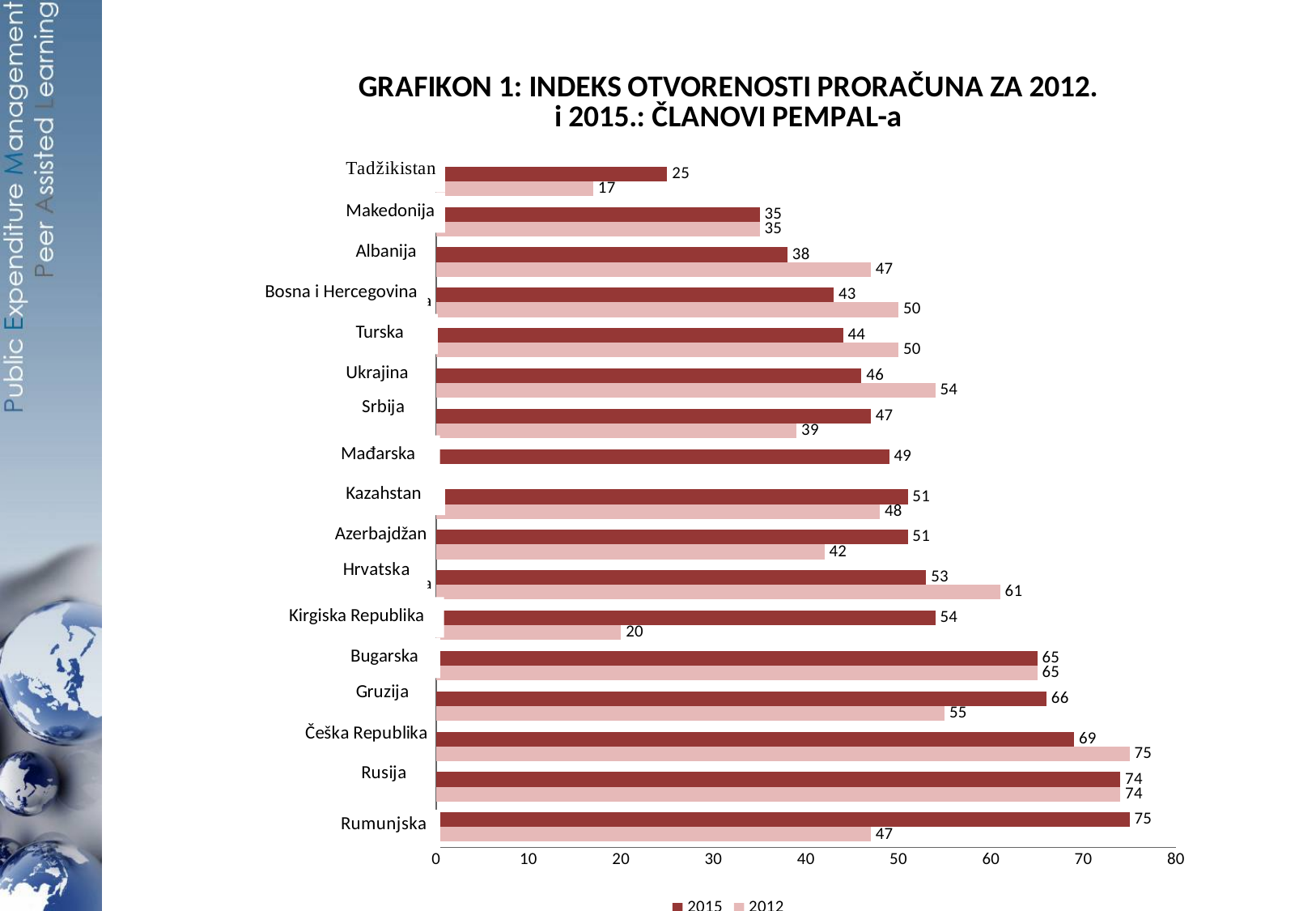
What is the difference between the 2015 and 2012 values for Rumunjska? 28 How many series does the legend list? 2 What is the 2015 value for Rumunjska? 75 What kind of chart is shown on the slide? bar chart Which is larger for Gruzija, the 2015 value or the 2012 value? 2015 What is the 2012 value for Kirgiska Republika? 20 Which series is shown in the darker red colour? 2015 Which country has the highest 2012 value? Češka Republika How many countries are shown on the chart? 17 What is the 2012 value for Hrvatska? 61 Is the 2015 value for Bugarska greater or less than 60? greater Which country has the lowest 2015 value? Tadžikistan